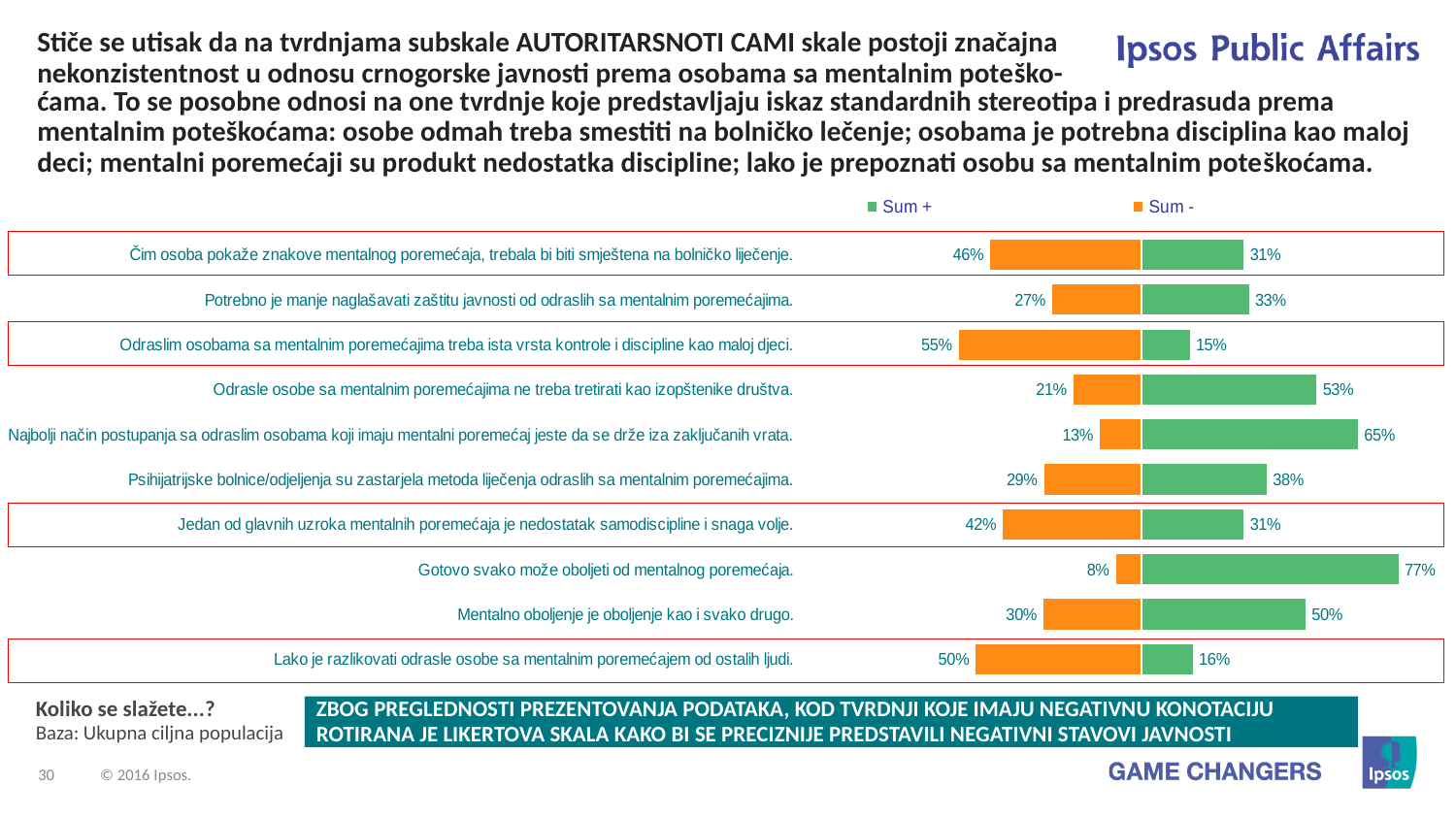
What is the Sum - value for "Odraslim osobama sa mentalnim poremećajima treba ista vrsta kontrole i discipline kao maloj djeci."? 55% Which colour represents the Sum - series in the chart? orange What is the Sum + value for "Gotovo svako može oboljeti od mentalnog poremećaja."? 77% What type of chart is shown on the slide? bar chart What is the difference between the Sum + and Sum - values for "Najbolji način postupanja sa odraslim osobama koji imaju mentalni poremećaj jeste da se drže iza zaključanih vrata."? 52% How many statements (categories) are plotted in the chart? 10 For "Čim osoba pokaže znakove mentalnog poremećaja, trebala bi biti smještena na bolničko liječenje.", which is larger, Sum + or Sum -? Sum - Which statement has the lowest Sum - value? Gotovo svako može oboljeti od mentalnog poremećaja. Which statement has the highest Sum + value? Gotovo svako može oboljeti od mentalnog poremećaja. What is the Sum + value for "Lako je razlikovati odrasle osobe sa mentalnim poremećajem od ostalih ljudi."? 16% How many series does the legend list? 2 What is the total of Sum + and Sum - for "Mentalno oboljenje je oboljenje kao i svako drugo."? 80%